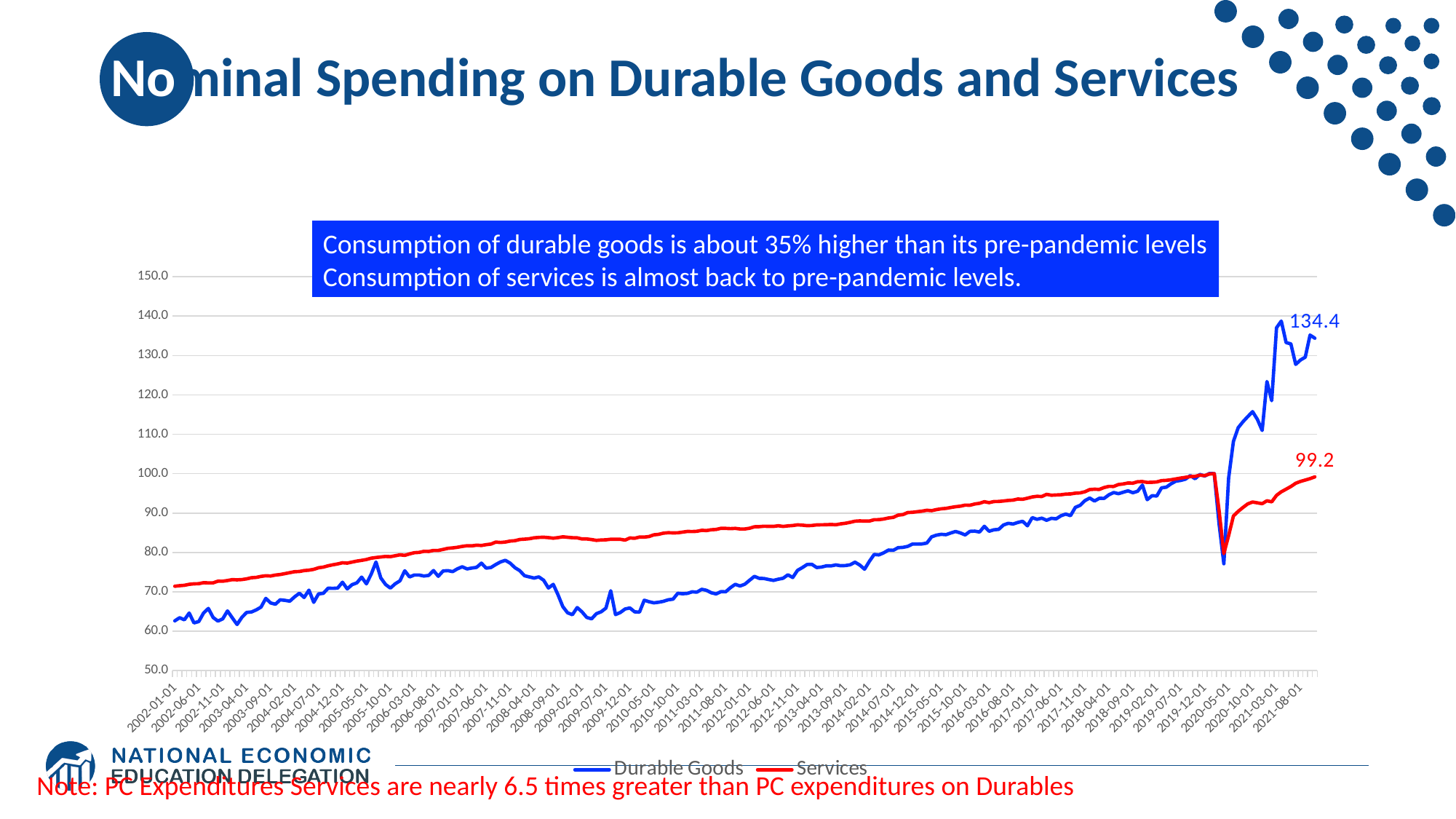
Is the value for Durable Goods at 2002-01-01 greater or less than 70? less What is the title of the slide containing the chart? Nominal Spending on Durable Goods and Services What is the final labelled value of the Services series? 99.2 How many series does the legend list? 2 Does the Services series generally rise or fall from 2002 to 2019? Rise What is the difference between the final labelled values of Durable Goods (134.4) and Services (99.2)? 35.2 What is the final labelled value of the Durable Goods series? 134.4 What colour is the Services line in the chart? Red Is the value for Services at 2019-12-01 greater or less than 90? greater Is the value for Services at 2002-01-01 greater or less than 80? less What kind of chart is shown on the slide? Line chart At the end of the chart, which series has the higher labelled value, Durable Goods or Services? Durable Goods